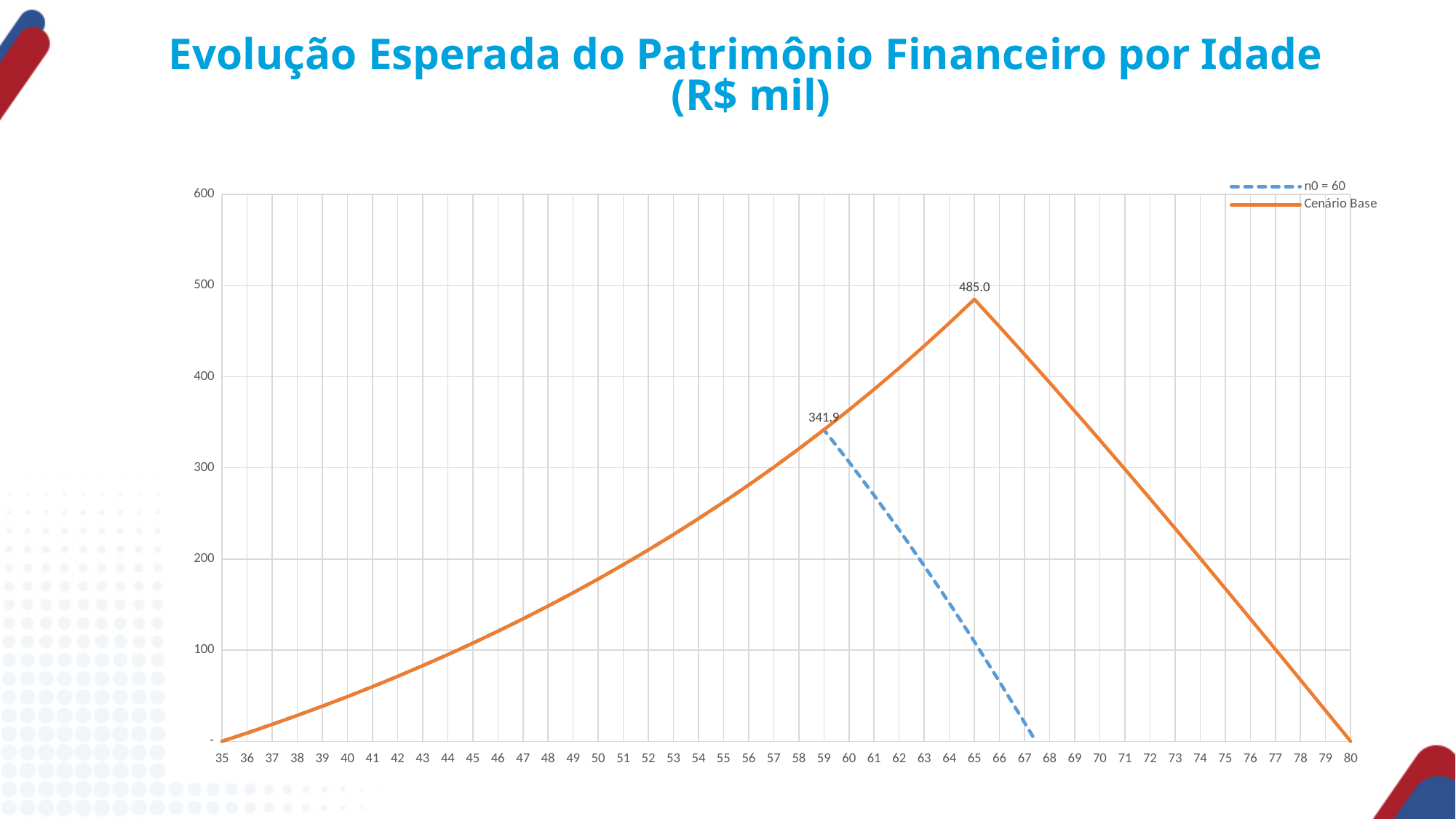
What is the value of the Cenário Base series at age 65? 485.0 What is the difference between the labelled values at age 65 and age 59? 143.1 What value is labelled at age 59 on the chart? 341.9 Which is larger for the Cenário Base series: the value at age 65 or the value at age 59? age 65 Is the value of the Cenário Base series at age 70 greater or less than 300? greater At which age does the Cenário Base series reach its highest value? 65 What kind of chart is shown on the slide? line chart What are the two series named in the legend? n0 = 60 and Cenário Base Is the value of the Cenário Base series at age 50 greater or less than 200? less Does the Cenário Base series rise or fall between age 65 and age 80? fall How many series does the legend list? 2 Is the value of the n0 = 60 series at age 61 greater or less than 200? greater